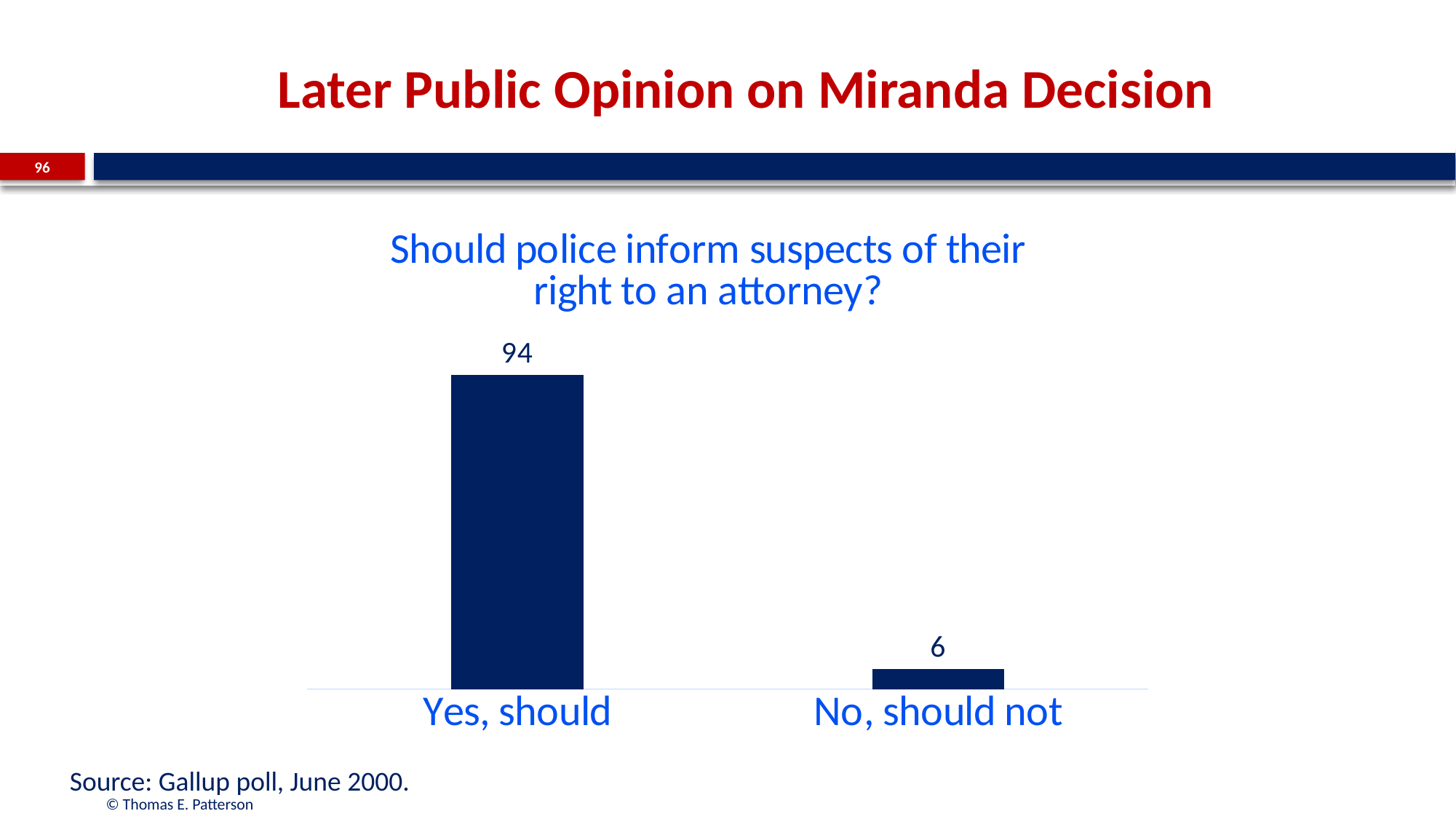
What kind of chart is shown on the slide? Bar chart What is the value for "Yes, should"? 94 What is the value for "No, should not"? 6 How many categories are shown in the chart? 2 Which is larger, the value for "Yes, should" or the value for "No, should not"? Yes, should What is the total of the two values shown in the chart? 100 What is the difference between the values for "Yes, should" and "No, should not"? 88 Which category has the lowest value? No, should not What is the title of the chart? Should police inform suspects of their right to an attorney? What is the source of the data shown in the chart? Gallup poll, June 2000 Which category has the highest value? Yes, should